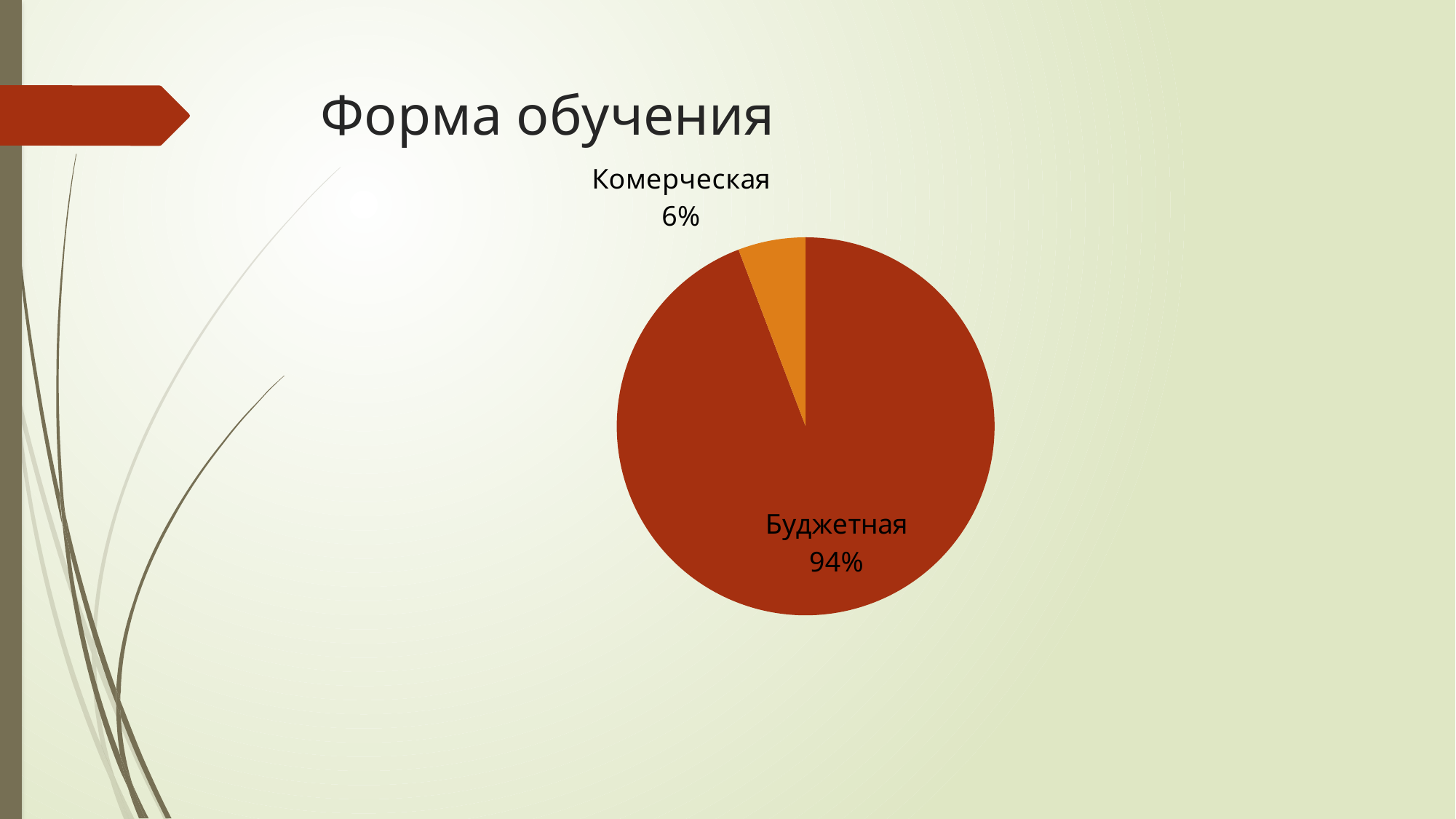
What is the difference in percentage points between Буджетная and Комерческая? 88 Which is larger, the share for Буджетная or the share for Комерческая? Буджетная How many slices does the pie chart have? 2 What share of the pie does Комерческая have? 6% Which category has the smallest slice of the pie? Комерческая What kind of chart is shown on the slide? pie chart Which category has the largest slice of the pie? Буджетная What colour is the Комерческая slice? orange What share of the pie does Буджетная have? 94% What is the title of the slide containing the pie chart? Форма обучения